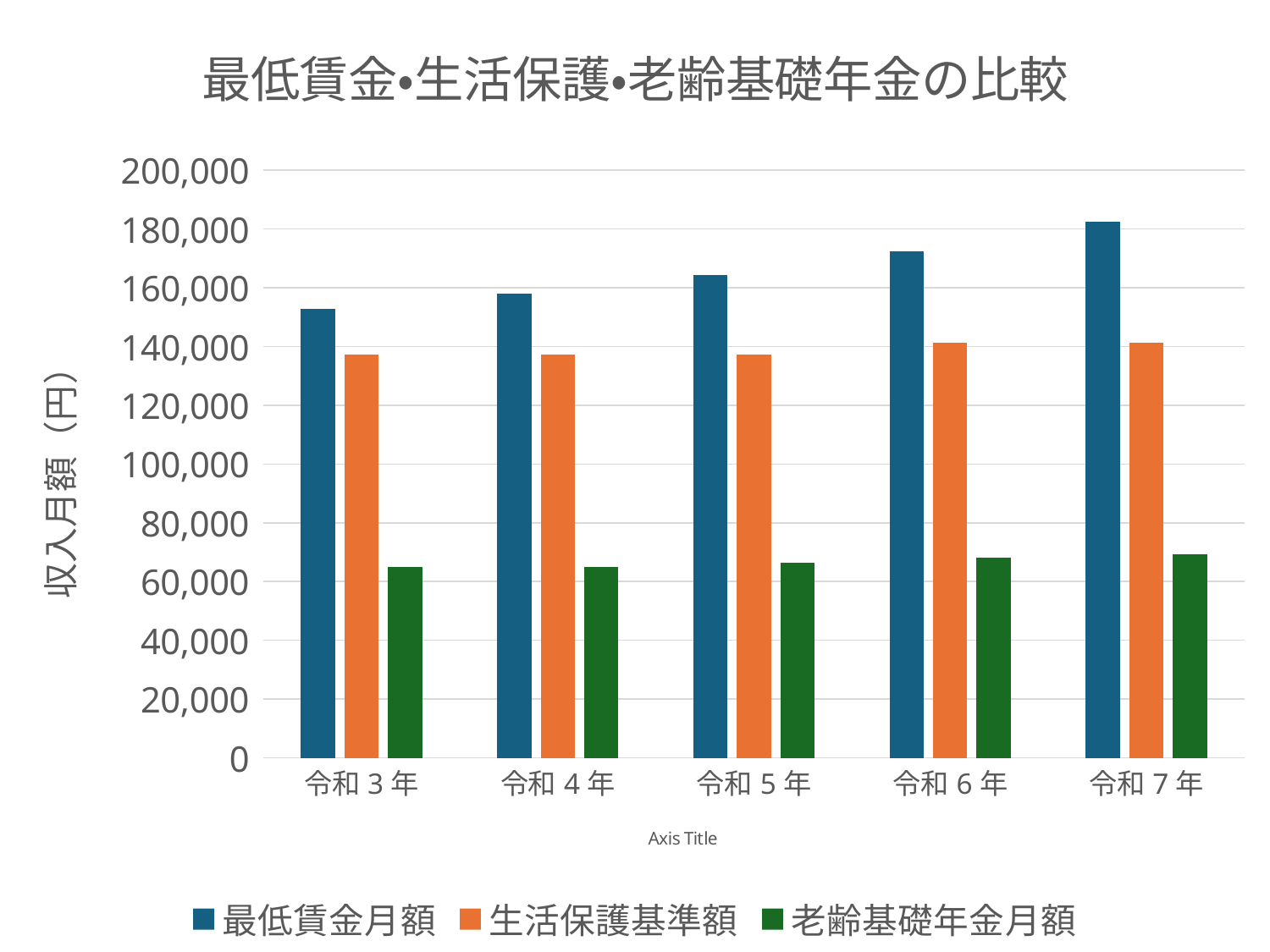
Is the value of 最低賃金月額 for 令和６年 greater or less than 160,000? greater How many year categories are shown on the x axis? 5 Is the value of 生活保護基準額 for 令和４年 greater or less than 140,000? less How many series does the legend list? 3 In which year is 最低賃金月額 the lowest? 令和３年 For 令和５年, which is larger: 最低賃金月額 or 老齢基礎年金月額? 最低賃金月額 What kind of chart is shown on the slide? bar chart In which year is 最低賃金月額 the highest? 令和７年 What is the title of the chart? 最低賃金•生活保護•老齢基礎年金の比較 Is the value of 老齢基礎年金月額 for 令和３年 greater or less than 60,000? greater Does 最低賃金月額 rise or fall from 令和３年 to 令和７年? rise